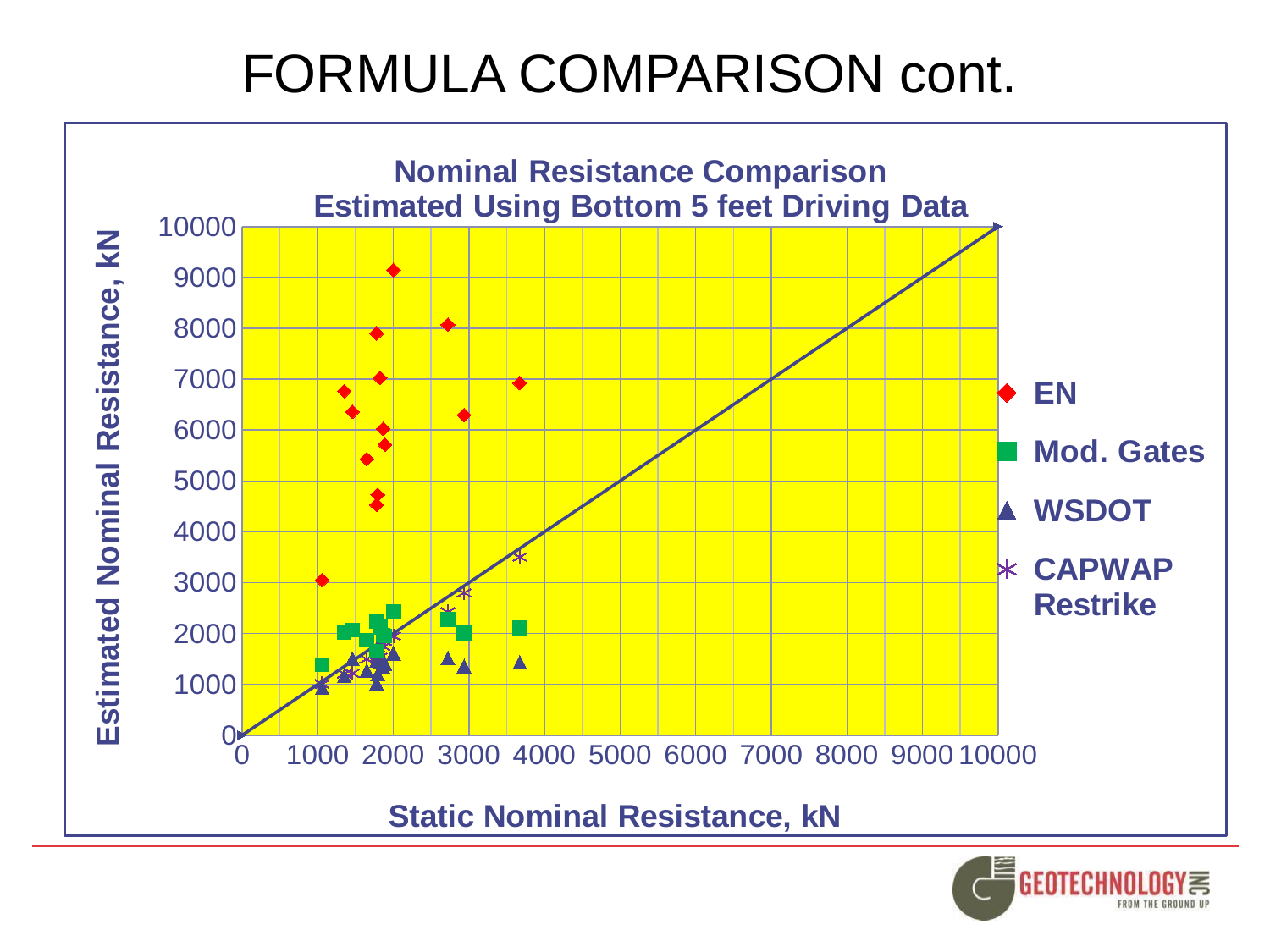
What is the label of the x axis? Static Nominal Resistance, kN What kind of chart is shown on the slide? Scatter chart Which series generally has larger Estimated Nominal Resistance values, EN or WSDOT? EN What is the maximum value shown on the Estimated Nominal Resistance axis? 10000 Is the highest EN point greater or less than 8000 kN on the Estimated Nominal Resistance axis? greater Is the highest CAPWAP Restrike point greater or less than 4000 kN on the Estimated Nominal Resistance axis? less Is the lowest EN point greater or less than 2000 kN on the Estimated Nominal Resistance axis? greater Which series has the highest plotted Estimated Nominal Resistance value? EN How many series does the legend list? 4 What is the title of the chart? Nominal Resistance Comparison Estimated Using Bottom 5 feet Driving Data